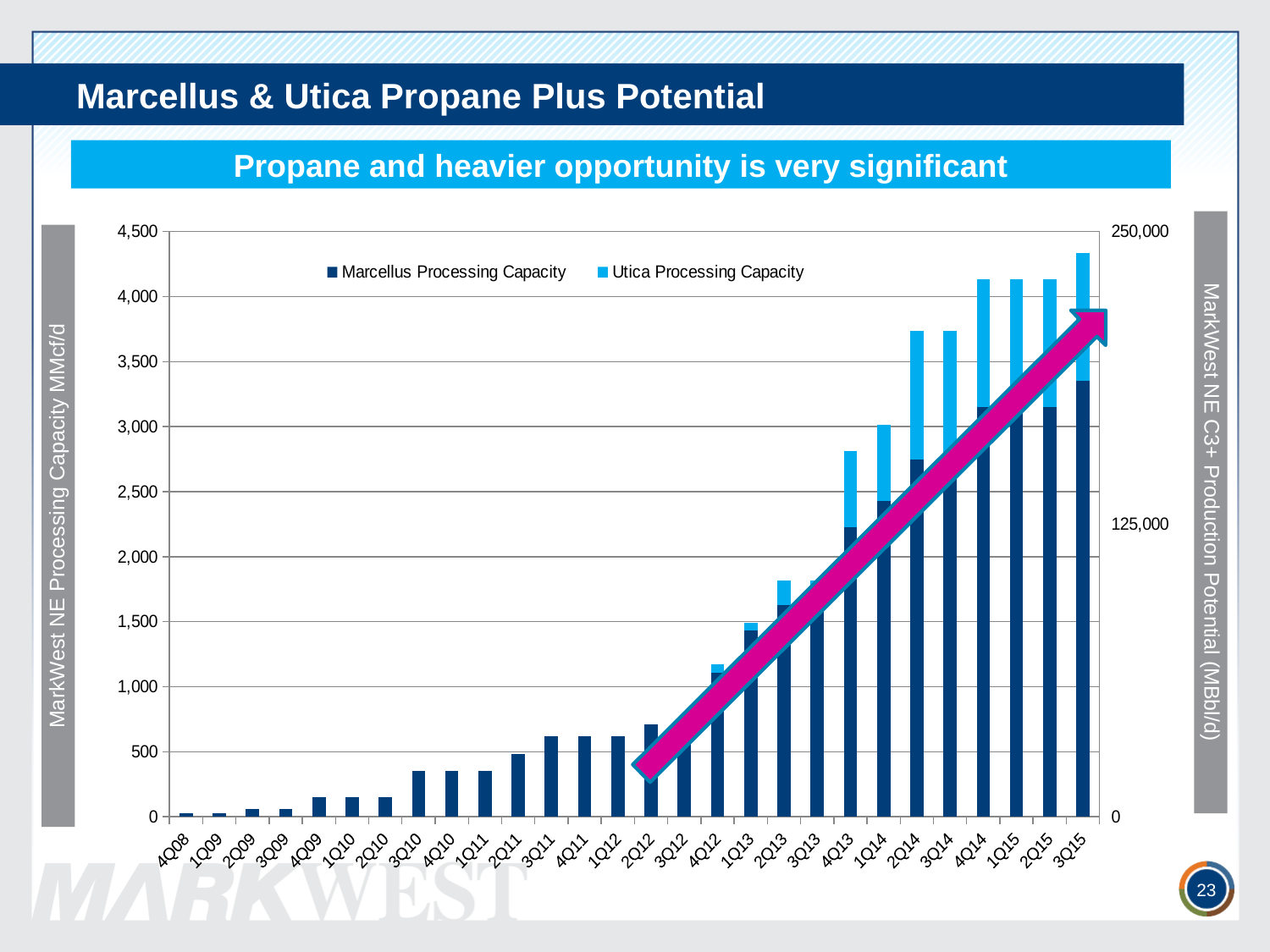
What kind of chart is shown on the slide? Stacked bar chart Is the Marcellus Processing Capacity for 2Q12 greater or less than 500? greater What is the title of the left vertical axis? MarkWest NE Processing Capacity MMcf/d Which series is shown in light blue in the legend? Utica Processing Capacity Is the total processing capacity for 3Q15 greater or less than 4,000? greater How many quarters are shown along the x axis? 28 How many series does the legend list? 2 Is the total processing capacity for 3Q11 greater or less than 1,000? less Which has the larger total processing capacity, 3Q14 or 4Q14? 4Q14 Do the total processing capacity values generally rise or fall from 4Q08 to 3Q15? Rise Which quarter has the highest total processing capacity? 3Q15